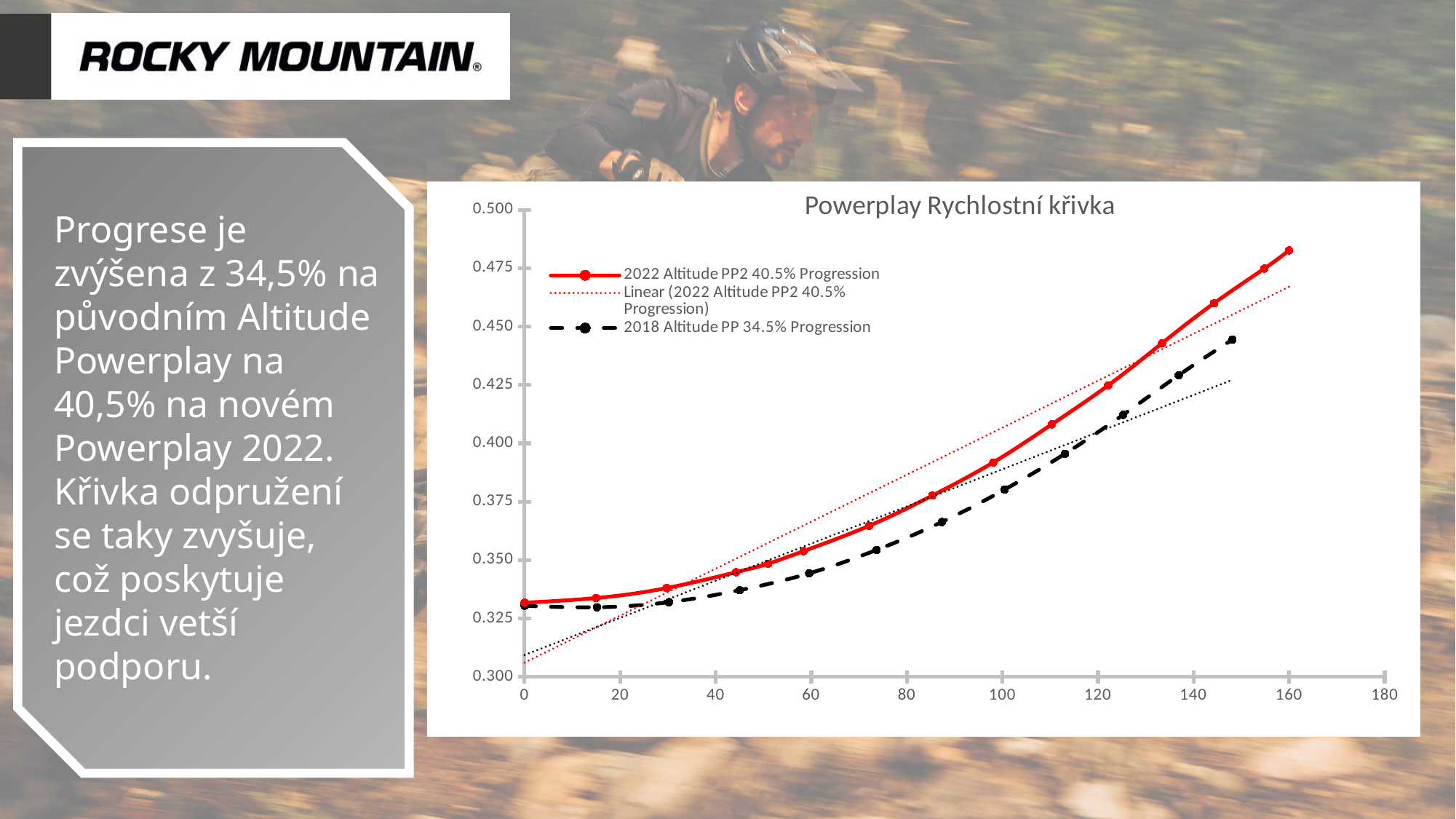
What colour is the line for the 2022 Altitude PP2 40.5% Progression series? red Is the value of the 2018 Altitude PP 34.5% Progression series at its last point greater or less than 0.475? less Which series reaches the highest value at the right end of the chart, 2022 Altitude PP2 40.5% Progression or 2018 Altitude PP 34.5% Progression? 2022 Altitude PP2 40.5% Progression Is the value of the 2022 Altitude PP2 40.5% Progression series at x = 80 greater or less than 0.400? less Is the value of the 2022 Altitude PP2 40.5% Progression series at x = 160 greater or less than 0.450? greater How many series does the chart legend list? 3 At x = 120, which series has the larger value, 2022 Altitude PP2 40.5% Progression or 2018 Altitude PP 34.5% Progression? 2022 Altitude PP2 40.5% Progression Do the values of the 2022 Altitude PP2 40.5% Progression series rise or fall as the x axis increases? rise What is the highest tick value shown on the x axis? 180 What is the title of the chart? Powerplay Rychlostní křivka What kind of chart is shown on the slide? line chart